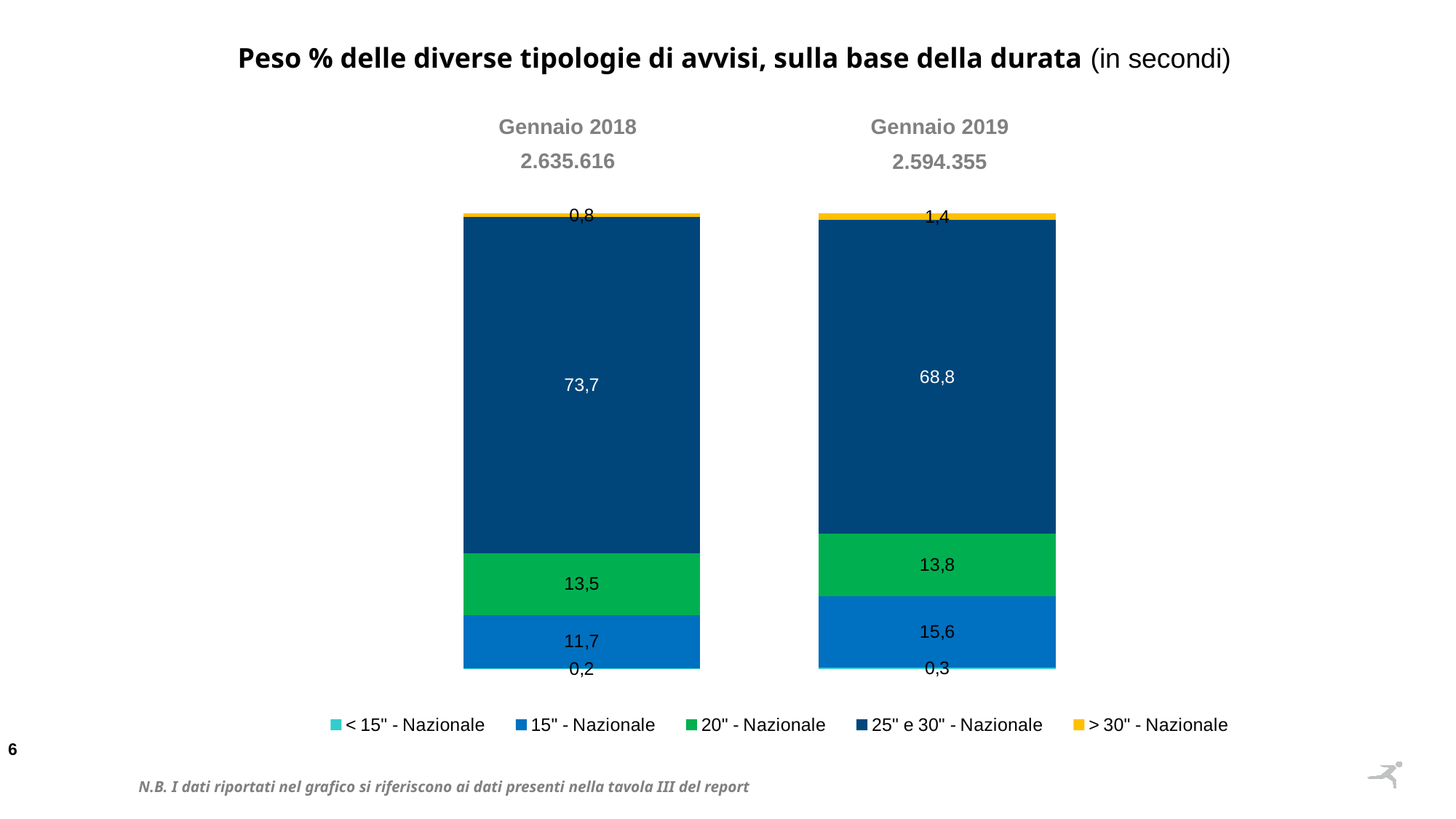
How many bars (periods) are plotted in the chart? 2 Which series has the largest share in the Gennaio 2019 bar? 25" e 30" - Nazionale What is the difference between the "25" e 30" - Nazionale" values for Gennaio 2018 and Gennaio 2019? 4,9 What total figure is printed under the Gennaio 2018 label? 2.635.616 Which series has the smallest share in the Gennaio 2018 bar? < 15" - Nazionale Is the "15" - Nazionale" value larger in Gennaio 2018 or Gennaio 2019? Gennaio 2019 What is the value for "15" - Nazionale" in Gennaio 2019? 15,6 What is the value for "< 15" - Nazionale" in Gennaio 2018? 0,2 What is the value for "25" e 30" - Nazionale" in Gennaio 2018? 73,7 What is the value for "> 30" - Nazionale" in Gennaio 2019? 1,4 What type of chart is shown on the slide? stacked bar chart How many series does the legend list? 5